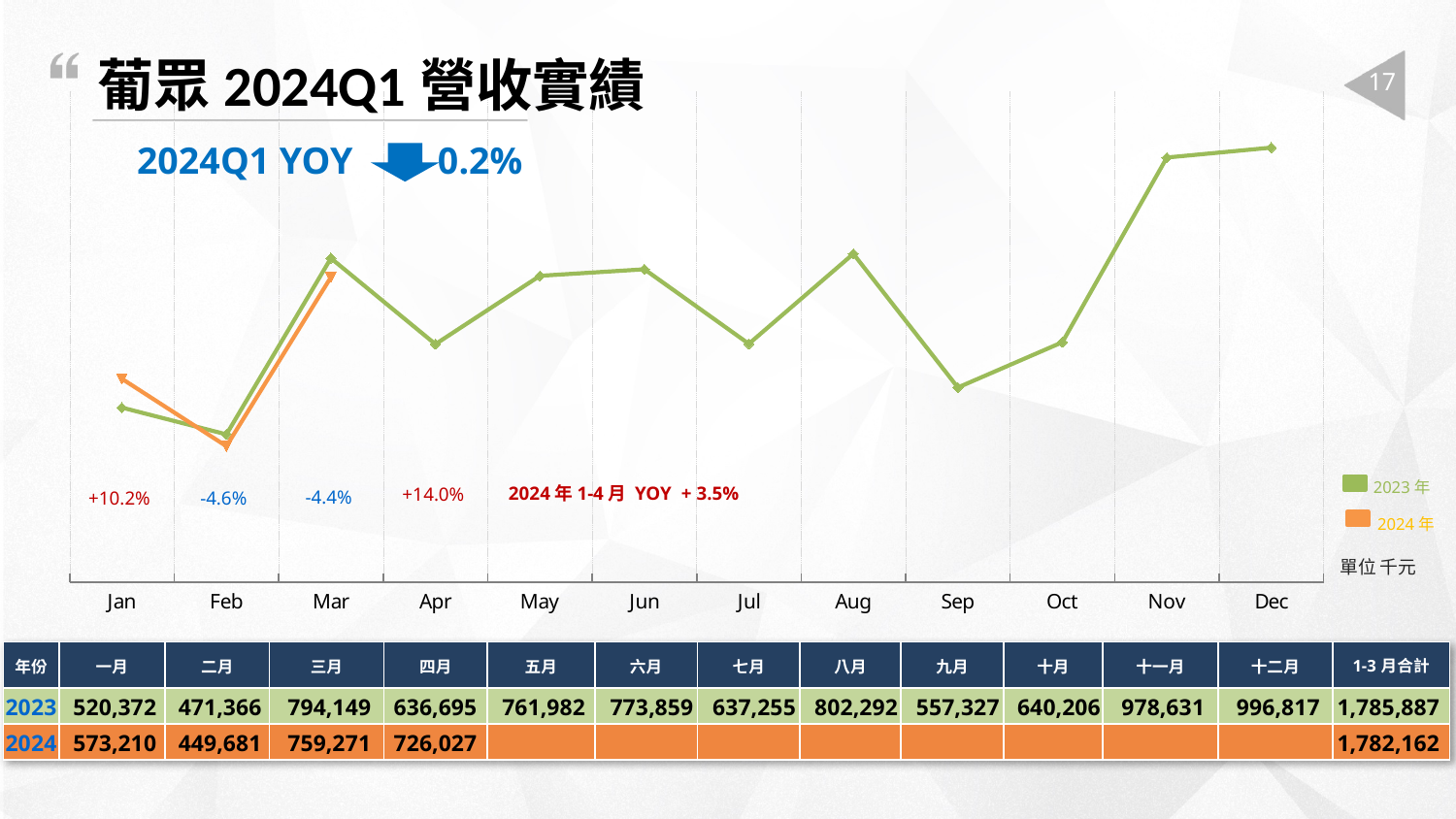
What kind of chart is shown on the slide? line chart Which month has the highest 2023 revenue? Dec What is the 2023 revenue value for Aug? 802,292 What is the difference between the 2024 and 2023 revenue values for Jan? 52,838 What is the 2024 revenue value for Mar? 759,271 What is the 2023 revenue value for Jan? 520,372 How many series does the legend list? 2 How many months are shown along the x axis of the chart? 12 What is the 1-3月合計 (Jan–Mar total) for 2024? 1,782,162 Which is larger, the 2023 revenue for Jul or for Aug? Aug Which month has the lowest 2023 revenue? Feb Does the 2023 line rise or fall from Sep to Dec? rise